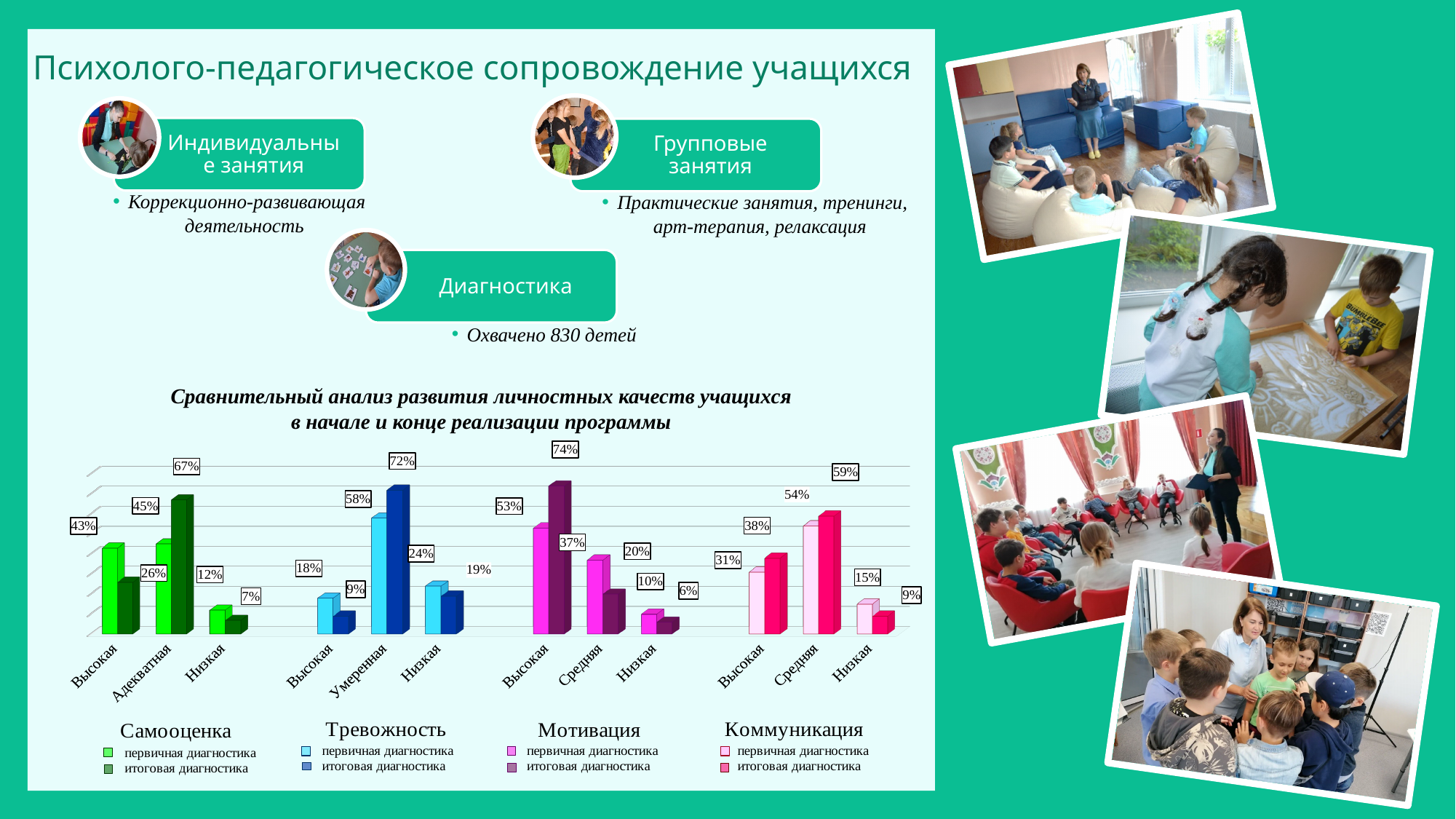
What is the value for итоговая диагностика of Адекватная самооценка? 67% Which category has the lowest value across the whole chart? Низкая мотивация (итоговая диагностика), 6% What is the value for первичная диагностика of Высокая самооценка? 43% What is the value for итоговая диагностика of Умеренная тревожность? 72% How many series does the legend list for each group? 2 What is the value for итоговая диагностика of Низкая коммуникация? 9% What is the difference between итоговая and первичная диагностика for Средняя мотивация? 17% Which category has the highest value across the whole chart? Высокая мотивация (итоговая диагностика), 74% What is the value for первичная диагностика of Высокая мотивация? 53% What kind of chart is shown on the slide? bar chart How many groups of personal qualities are shown on the chart? 4 Which is larger for Высокая тревожность: первичная диагностика or итоговая диагностика? первичная диагностика